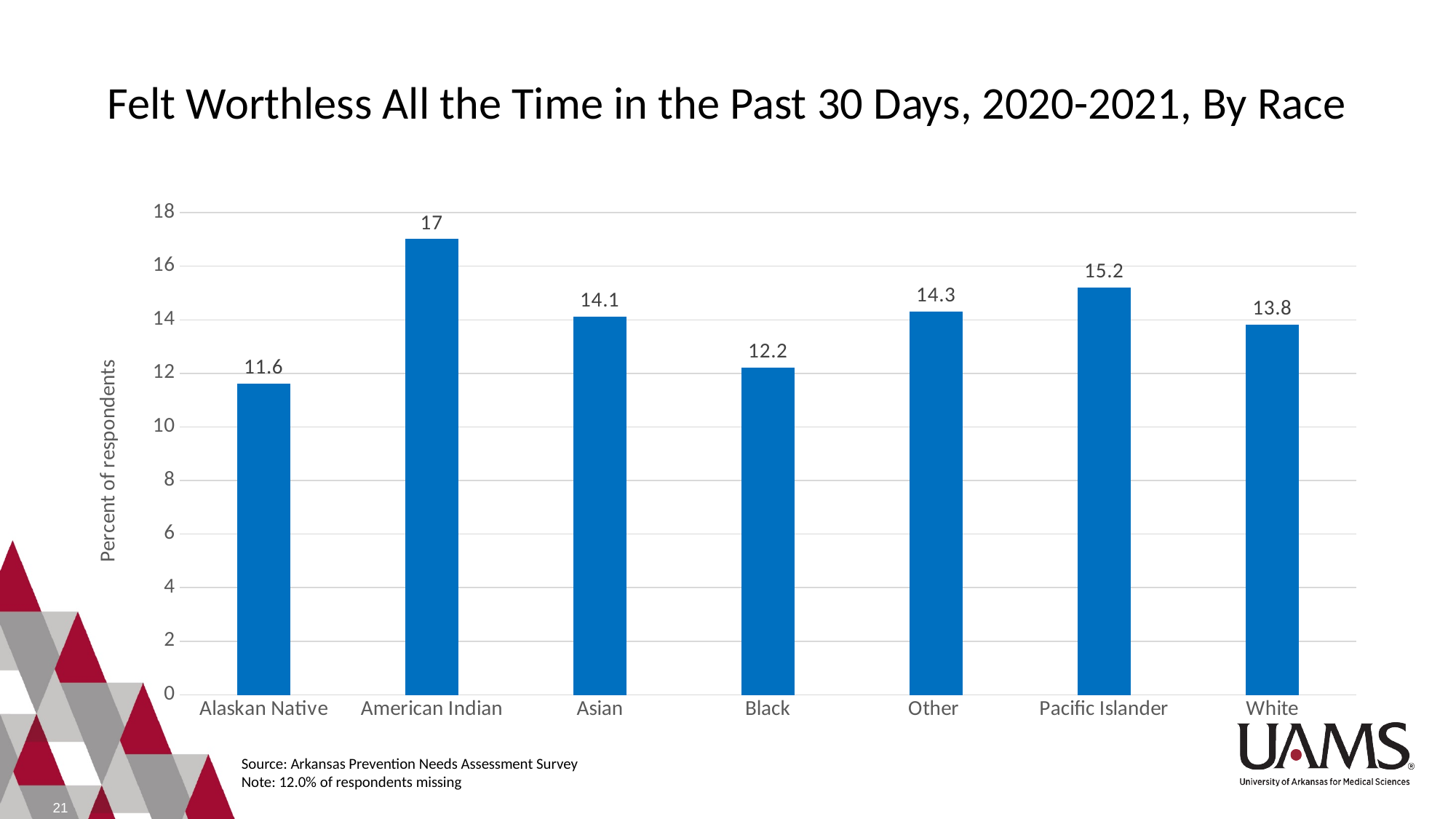
What is the label of the vertical axis? Percent of respondents Which race has the lowest value? Alaskan Native Which is larger, the value for Other or the value for Black? Other What is the value for American Indian? 17 How many race categories are shown on the chart? 7 Is the value for Asian greater or less than 12? greater What is the value for Pacific Islander? 15.2 What is the value for Black? 12.2 What kind of chart is shown on the slide? bar chart What is the difference between the values for Pacific Islander and White? 1.4 Which race has the highest value? American Indian What is the difference between the values for American Indian and Alaskan Native? 5.4